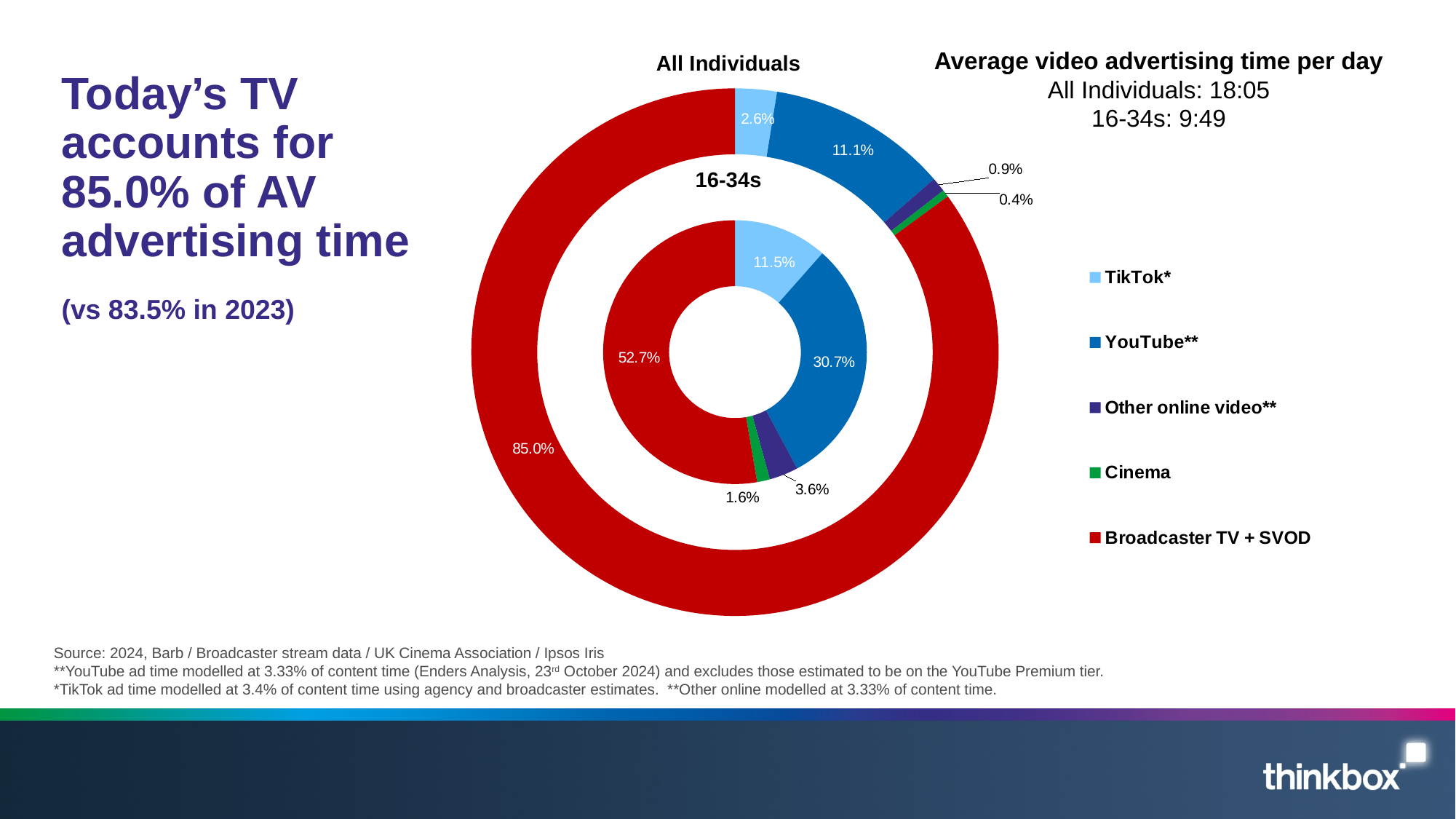
What share of AV advertising time does Broadcaster TV + SVOD account for among All Individuals? 85.0% What share of AV advertising time does YouTube** account for among 16-34s? 30.7% What kind of chart is shown on the slide? Doughnut chart What is the Other online video** share for All Individuals? 0.9% What is the Cinema share for 16-34s? 1.6% Which category has the largest share among 16-34s? Broadcaster TV + SVOD What is the TikTok* share for All Individuals? 2.6% Which is larger: the YouTube** share for 16-34s or the TikTok* share for 16-34s? YouTube** share for 16-34s How many categories does the legend list? 5 Which category has the smallest share among All Individuals? Cinema How much larger is the Broadcaster TV + SVOD share for All Individuals than for 16-34s? 32.3 percentage points Which colour represents Broadcaster TV + SVOD in the chart? Red